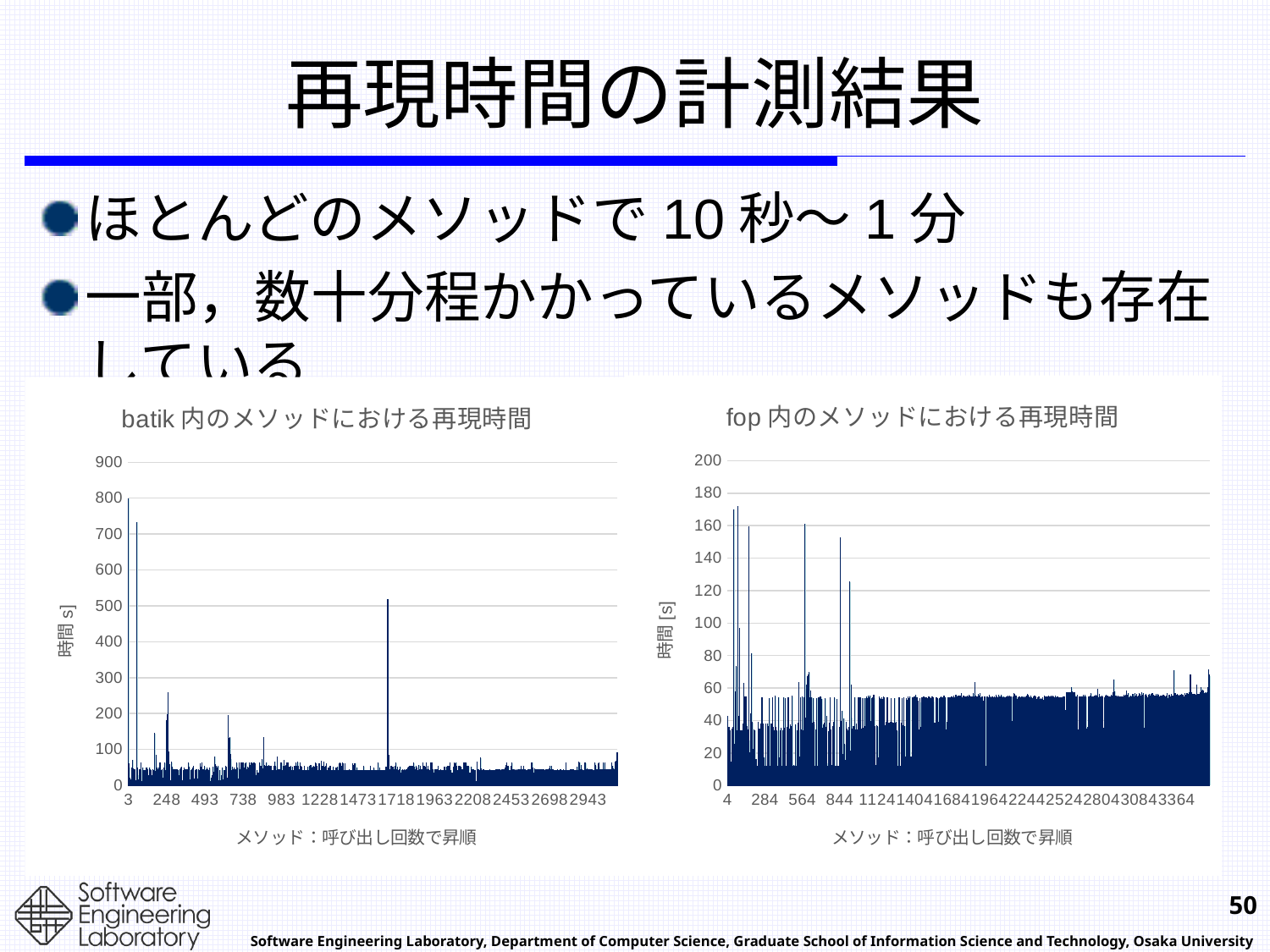
What is the x-axis label of the right chart (fop)? メソッド：呼び出し回数で昇順 In the left chart (batik), is the isolated spike near x = 1718 greater or less than 600? less What kind of chart is the left chart titled 'batik 内のメソッドにおける再現時間'? bar chart Which chart has the taller maximum bar, the batik chart or the fop chart? batik chart In the left chart (batik), is the isolated spike near x = 1718 greater or less than 400? greater In the right chart (fop), is the tallest bar greater or less than 140? greater What kind of chart is the right chart titled 'fop 内のメソッドにおける再現時間'? bar chart What is the highest y-axis tick value shown on the left chart (batik)? 900 What is the y-axis label of the left chart (batik)? 時間 [s]